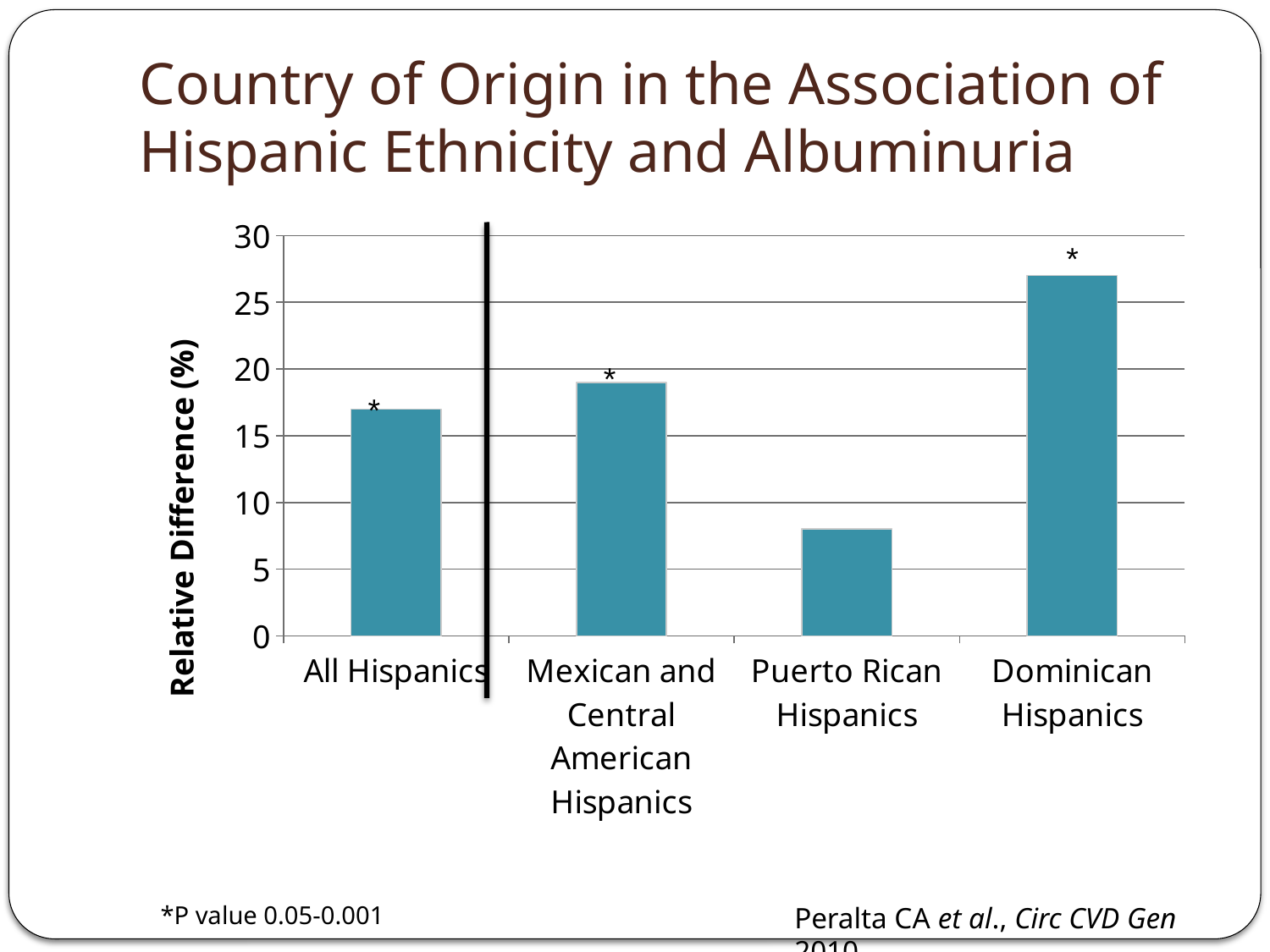
How many categories are shown on the x axis of the chart? 4 Which category's bar does not have an asterisk above it? Puerto Rican Hispanics Is the value for Puerto Rican Hispanics greater or less than 10? less What type of chart is shown on the slide? bar chart What is the label of the y axis of the chart? Relative Difference (%) Which category has the highest relative difference? Dominican Hispanics Which is larger, the value for Mexican and Central American Hispanics or the value for Puerto Rican Hispanics? Mexican and Central American Hispanics Which category has the lowest relative difference? Puerto Rican Hispanics Which is larger, the value for Dominican Hispanics or the value for All Hispanics? Dominican Hispanics Is the value for Mexican and Central American Hispanics greater or less than 20? less Is the value for All Hispanics greater or less than 15? greater